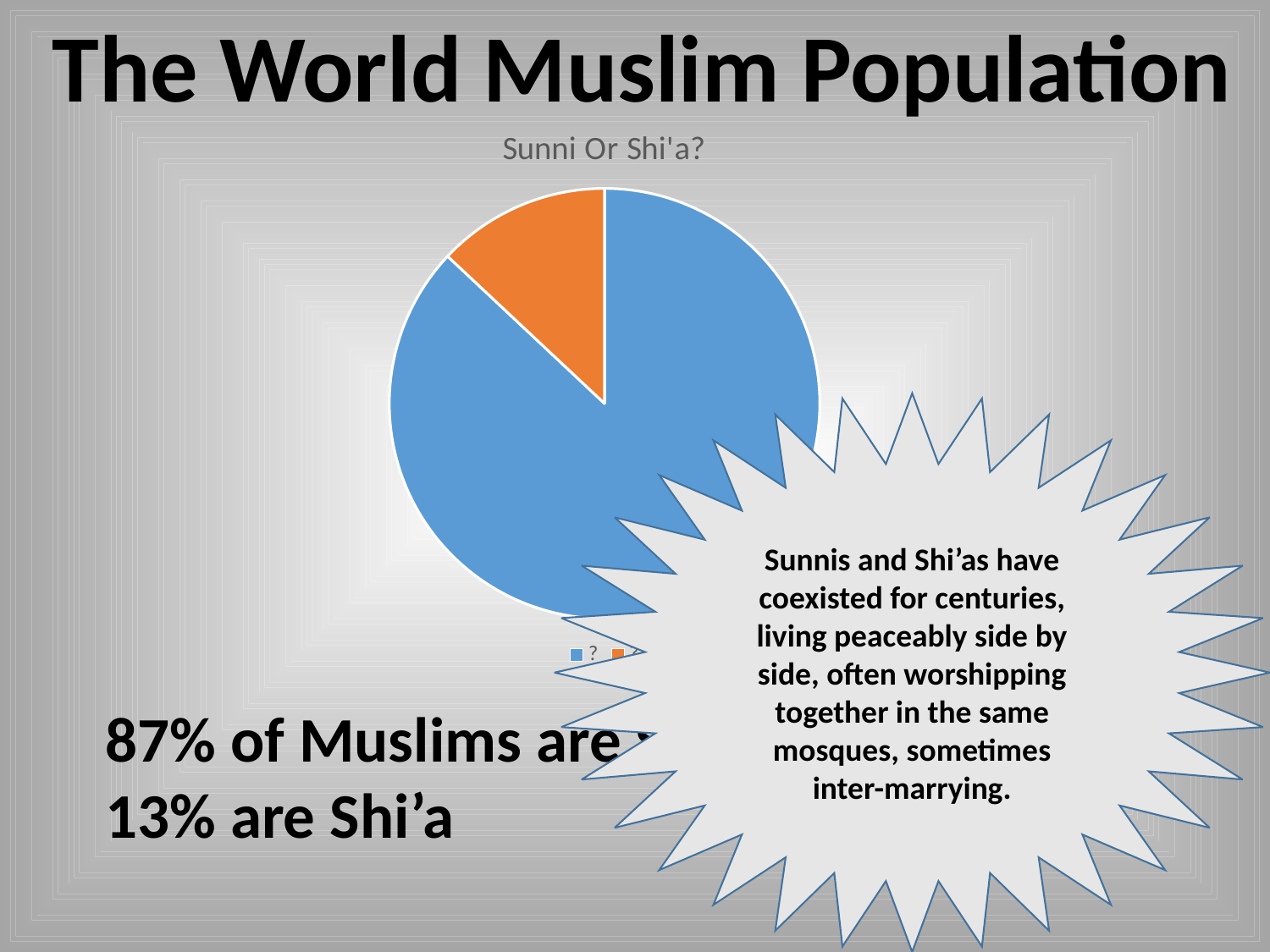
Is the blue slice's share of the pie greater or less than 50%? greater Which slice of the pie chart is larger, the blue one or the orange one? blue What colour is the larger slice of the pie chart? blue What kind of chart is shown on the slide? pie chart How many entries does the pie chart's legend list? 2 According to the text on the slide, what percentage of Muslims are Shi'a? 13% Which colour slice is the smallest in the pie chart? orange What is the difference between the two percentages stated on the slide (87% and 13%)? 74% How many slices does the pie chart have? 2 Is the orange slice's share of the pie greater or less than 25%? less According to the text on the slide, what percentage is given for the larger group of Muslims? 87% What is the title of the pie chart? Sunni Or Shi'a?